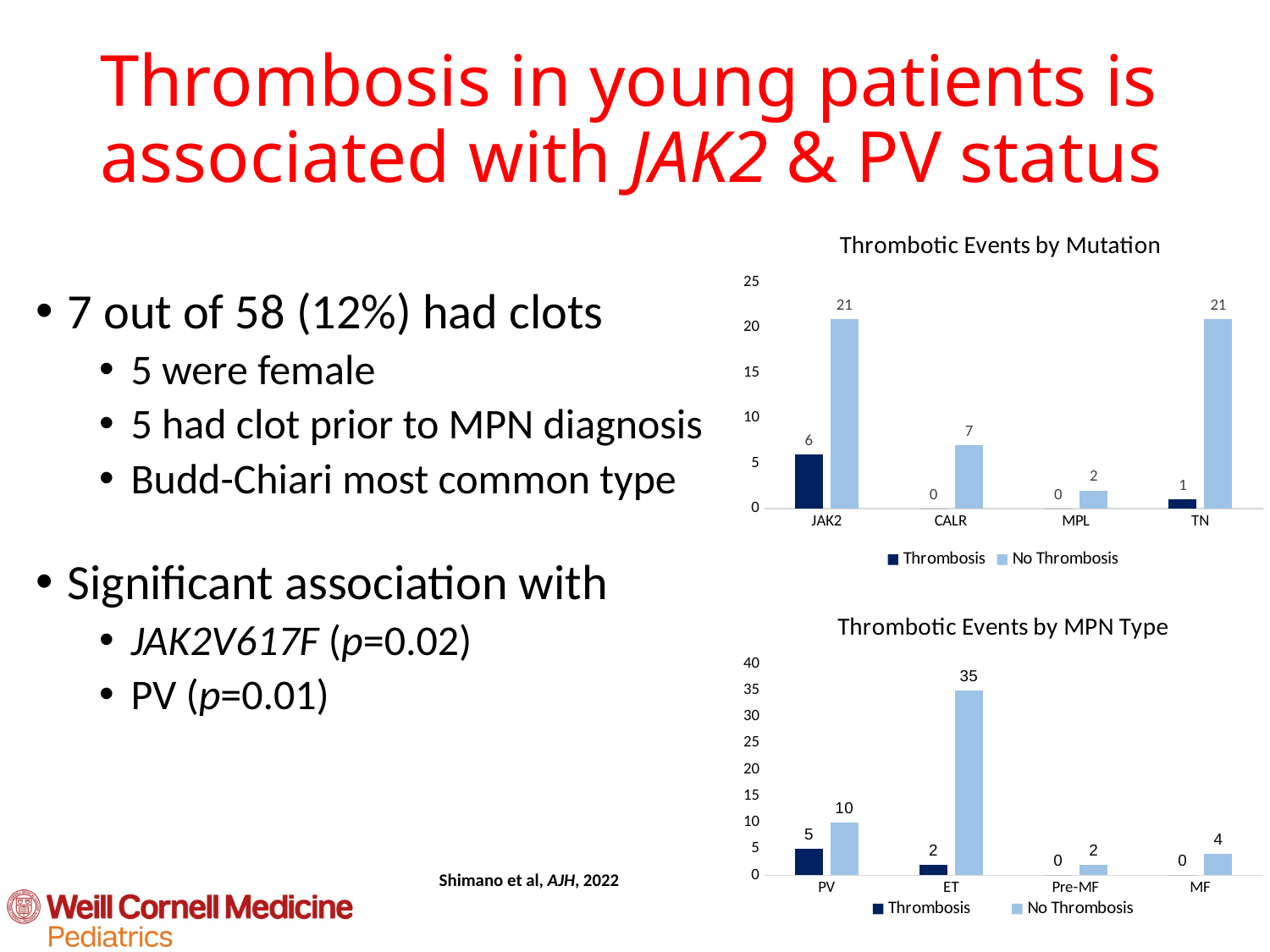
In the 'Thrombotic Events by Mutation' chart, how many mutation categories are shown on the x axis? 4 What kind of chart is 'Thrombotic Events by MPN Type'? Bar chart In the 'Thrombotic Events by MPN Type' chart, what is the No Thrombosis value for ET? 35 In the 'Thrombotic Events by Mutation' chart, which mutation has the highest Thrombosis value? JAK2 In the 'Thrombotic Events by Mutation' chart, what is the No Thrombosis value for CALR? 7 In the 'Thrombotic Events by MPN Type' chart, which MPN type has the lowest No Thrombosis value? Pre-MF In the 'Thrombotic Events by Mutation' chart, how many series does the legend list? 2 In the 'Thrombotic Events by MPN Type' chart, what is the Thrombosis value for PV? 5 In the 'Thrombotic Events by Mutation' chart, what is the difference between the No Thrombosis and Thrombosis values for JAK2? 15 In the 'Thrombotic Events by Mutation' chart, what is the Thrombosis value for JAK2? 6 In the 'Thrombotic Events by MPN Type' chart, is the No Thrombosis value for PV larger or the No Thrombosis value for MF? PV In the 'Thrombotic Events by MPN Type' chart, what is the total of Thrombosis and No Thrombosis for PV? 15